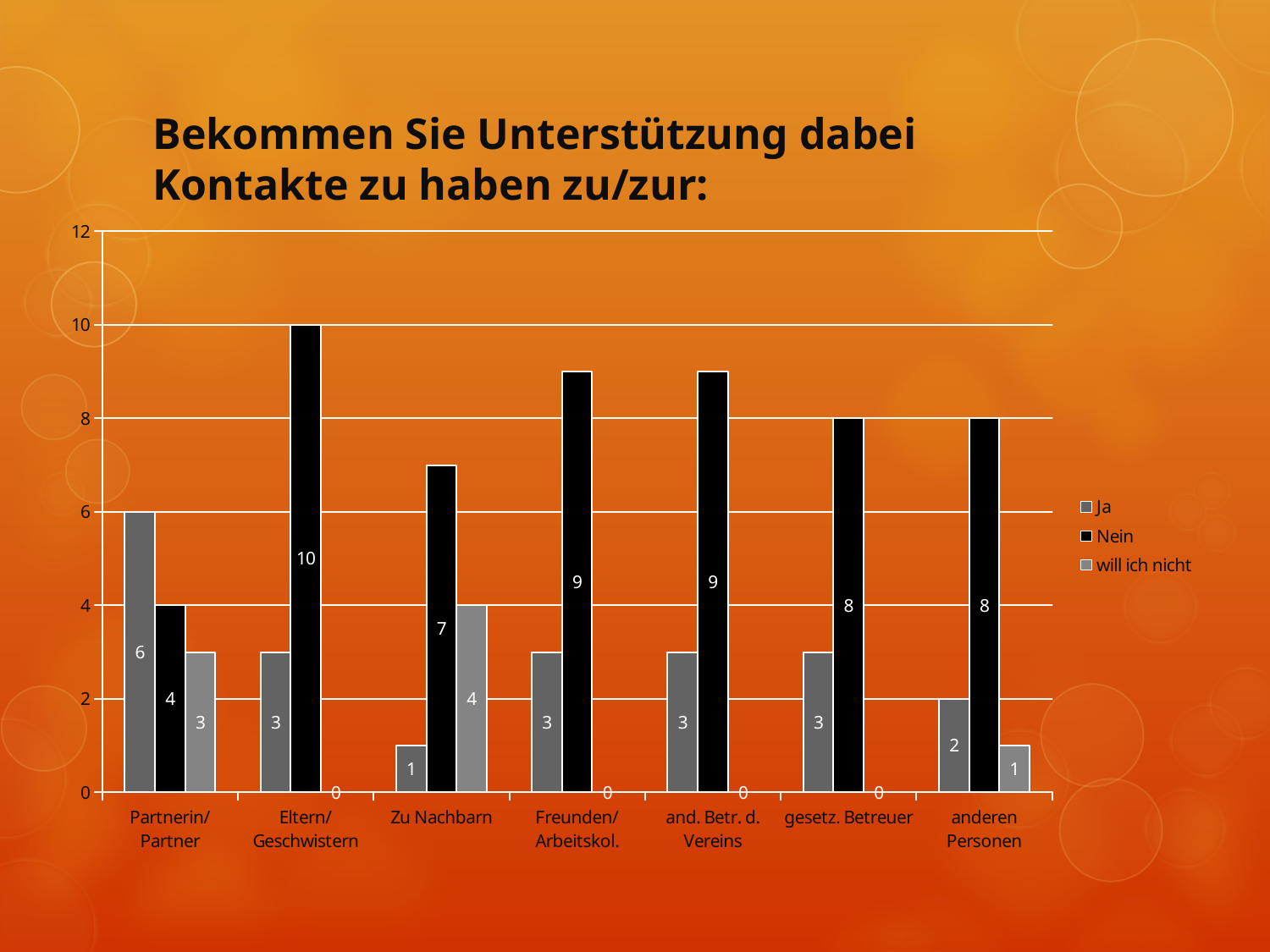
How many categories are shown on the x axis? 7 What is the difference between the "Nein" and "Ja" values for Zu Nachbarn? 6 Which category has the lowest "Ja" value? Zu Nachbarn Which category has the highest "Nein" value? Eltern/Geschwistern How many series does the legend list? 3 Which is larger for anderen Personen: the "Ja" value or the "Nein" value? Nein Which series is shown in black in the legend? Nein What is the value of "Ja" for Partnerin/Partner? 6 What is the value of "Nein" for Eltern/Geschwistern? 10 What is the value of "will ich nicht" for Freunden/Arbeitskol.? 0 What is the value of "will ich nicht" for Zu Nachbarn? 4 What kind of chart is shown on the slide? Bar chart